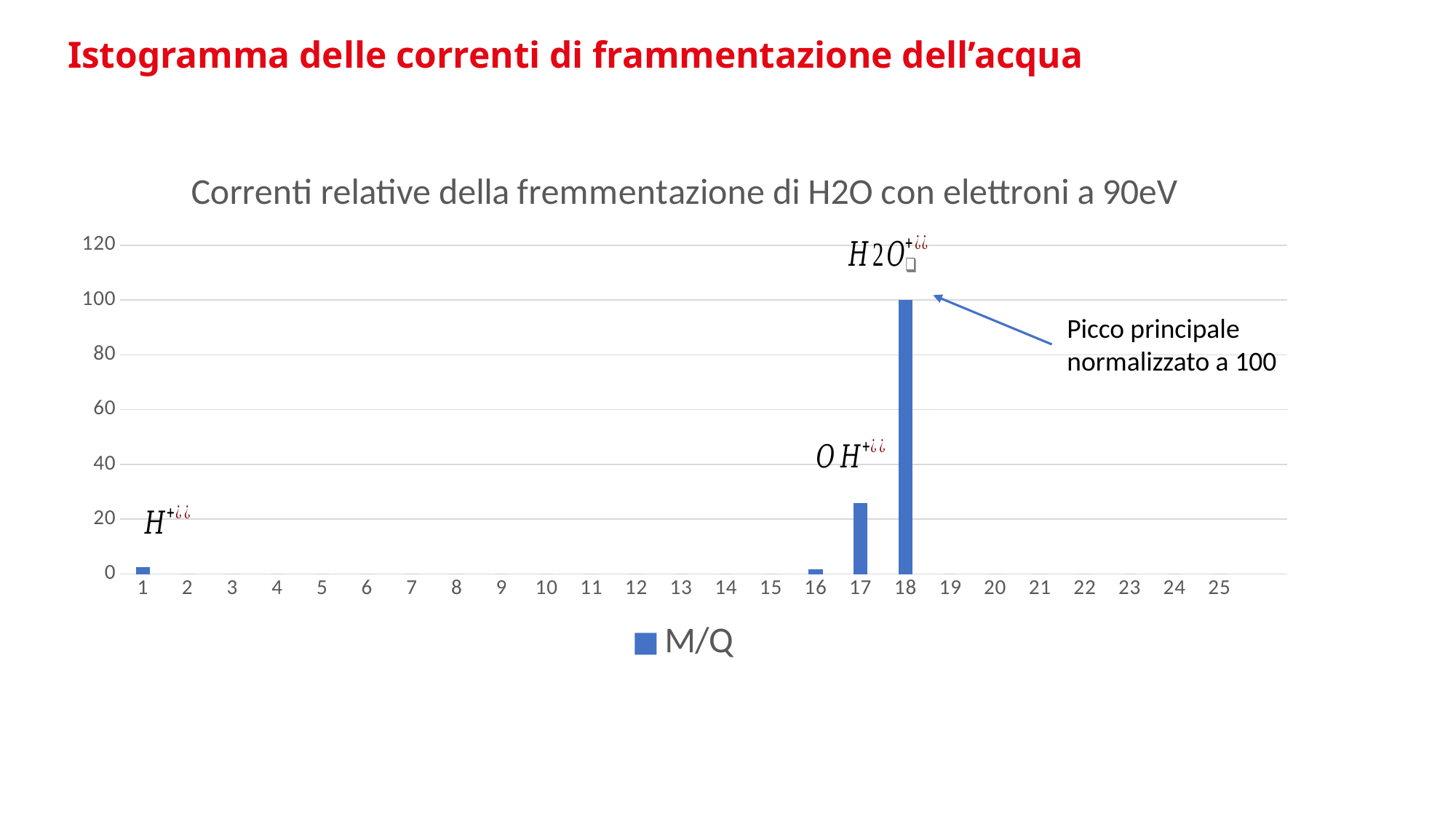
What is the title of the chart? Correnti relative della fremmentazione di H2O con elettroni a 90eV Is the value for category 17 greater or less than 20? greater Which category has the highest bar? 18 How many series does the legend list? 1 What kind of chart is shown on the slide? Bar chart Is the value for category 1 greater or less than 20? less How many categories are shown on the x axis? 25 What is the value of the bar at category 18? 100 Which is larger, the bar at category 18 or the bar at category 17? 18 Is the value for category 17 greater or less than 40? less What series name is shown in the legend? M/Q Which is larger, the bar at category 17 or the bar at category 1? 17